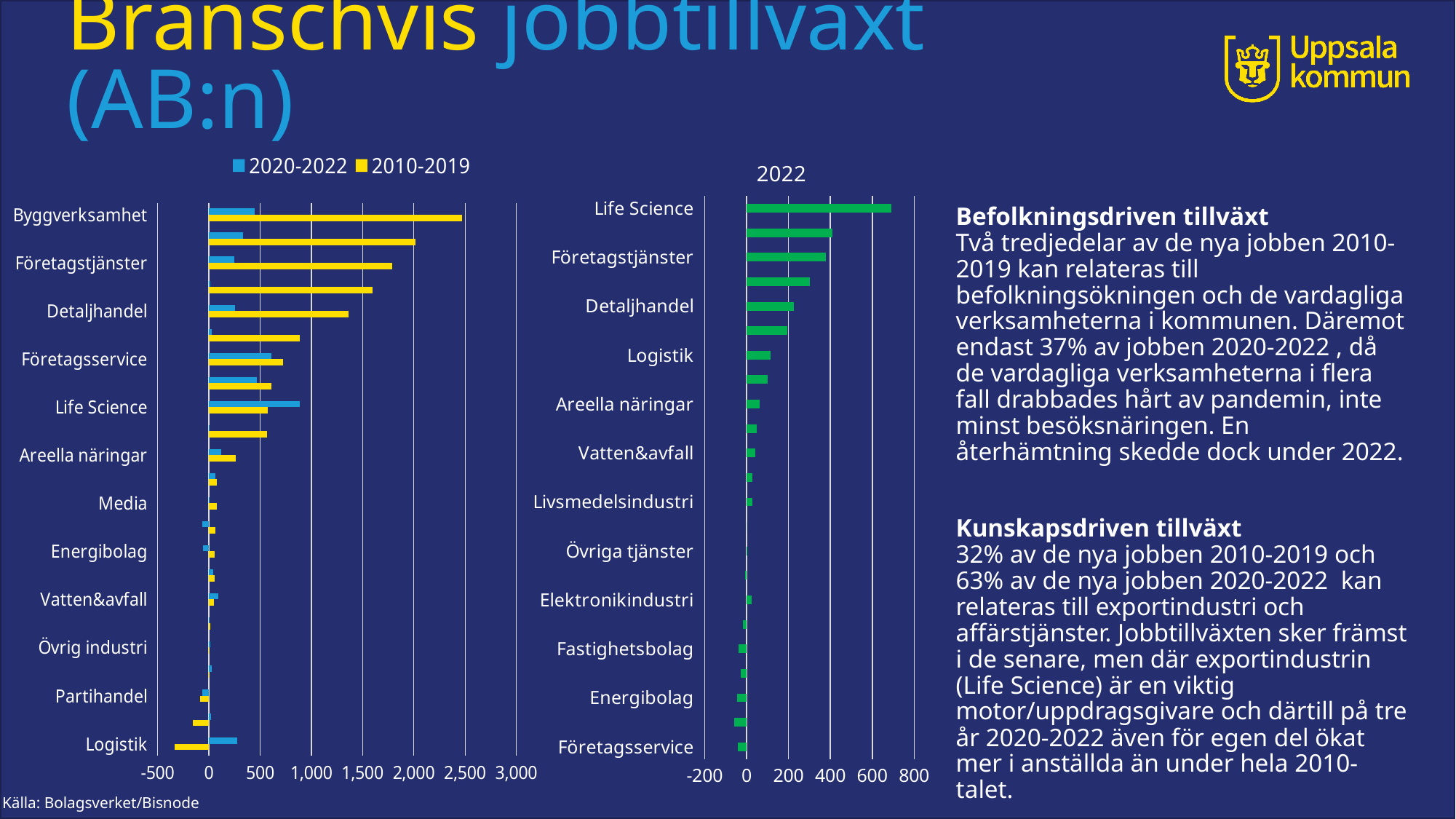
In the chart titled 2022, which category has the highest value? Life Science In the left chart, which colour represents the 2010-2019 series? yellow In the chart titled 2022, is the value for Life Science greater or less than 600? greater In the left chart, is the 2010-2019 value for Företagstjänster greater or less than 1,500? greater In the left chart, which labelled category has the lowest value for 2010-2019? Logistik What kind of chart is the left chart with the 2020-2022 and 2010-2019 series? bar chart In the left chart, which is larger for 2020-2022: Life Science or Areella näringar? Life Science How many series does the legend of the left chart list? 2 In the chart titled 2022, is the value for Företagsservice greater or less than 0? less In the left chart, which category has the highest value for 2010-2019? Byggverksamhet